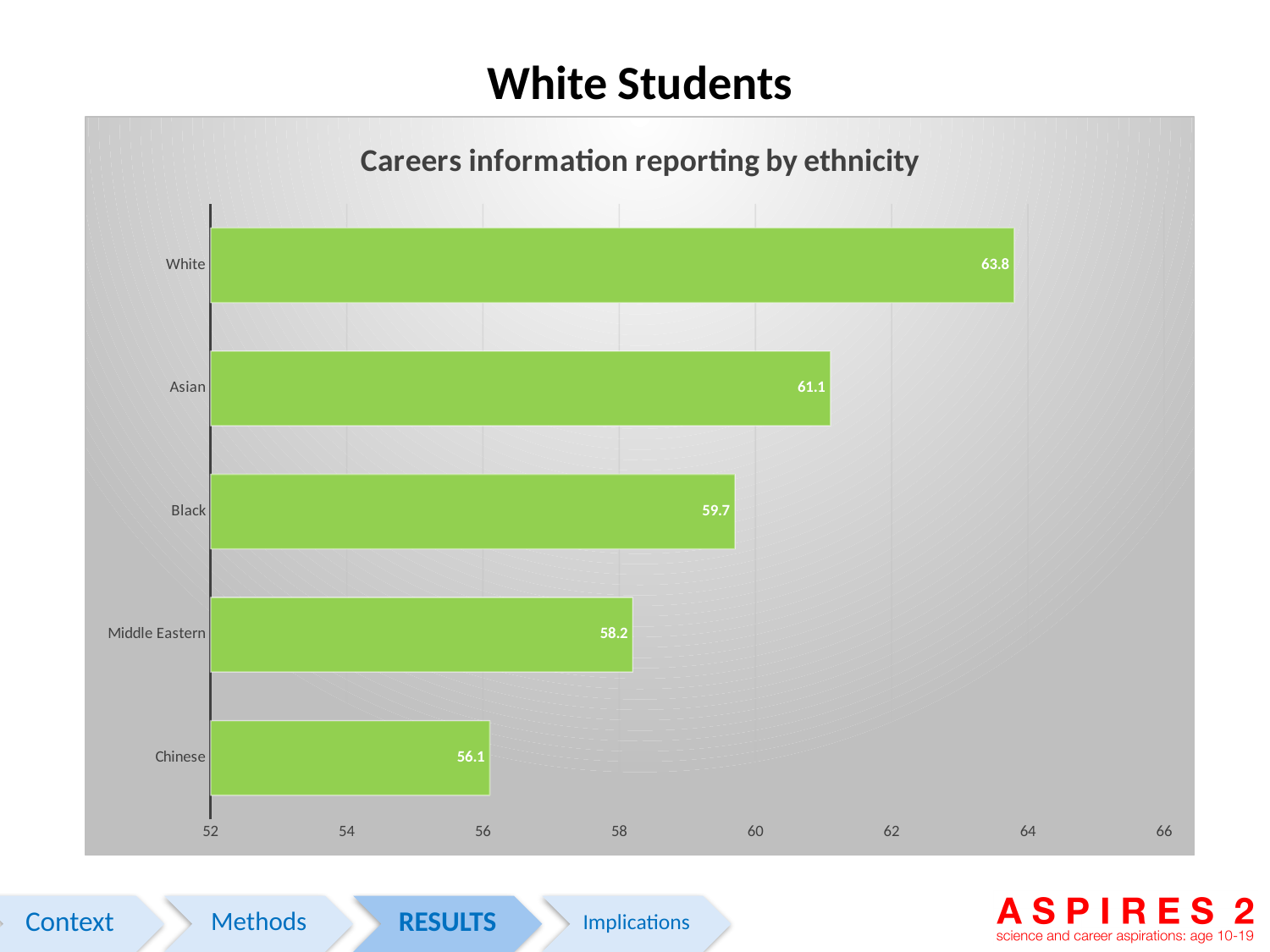
What is the value for Asian in the chart? 61.1 Which ethnicity has the highest value? White Is the value for Chinese greater or less than 58? less What is the value for Middle Eastern in the chart? 58.2 How many ethnicity categories are shown in the chart? 5 What is the difference between the values for White and Chinese? 7.7 What is the difference between the values for Asian and Black? 1.4 Which ethnicity has the lowest value? Chinese What is the value for White in the chart? 63.8 Which is larger, the value for Black or the value for Middle Eastern? Black What is the title of the chart? Careers information reporting by ethnicity What kind of chart is shown on the slide? bar chart